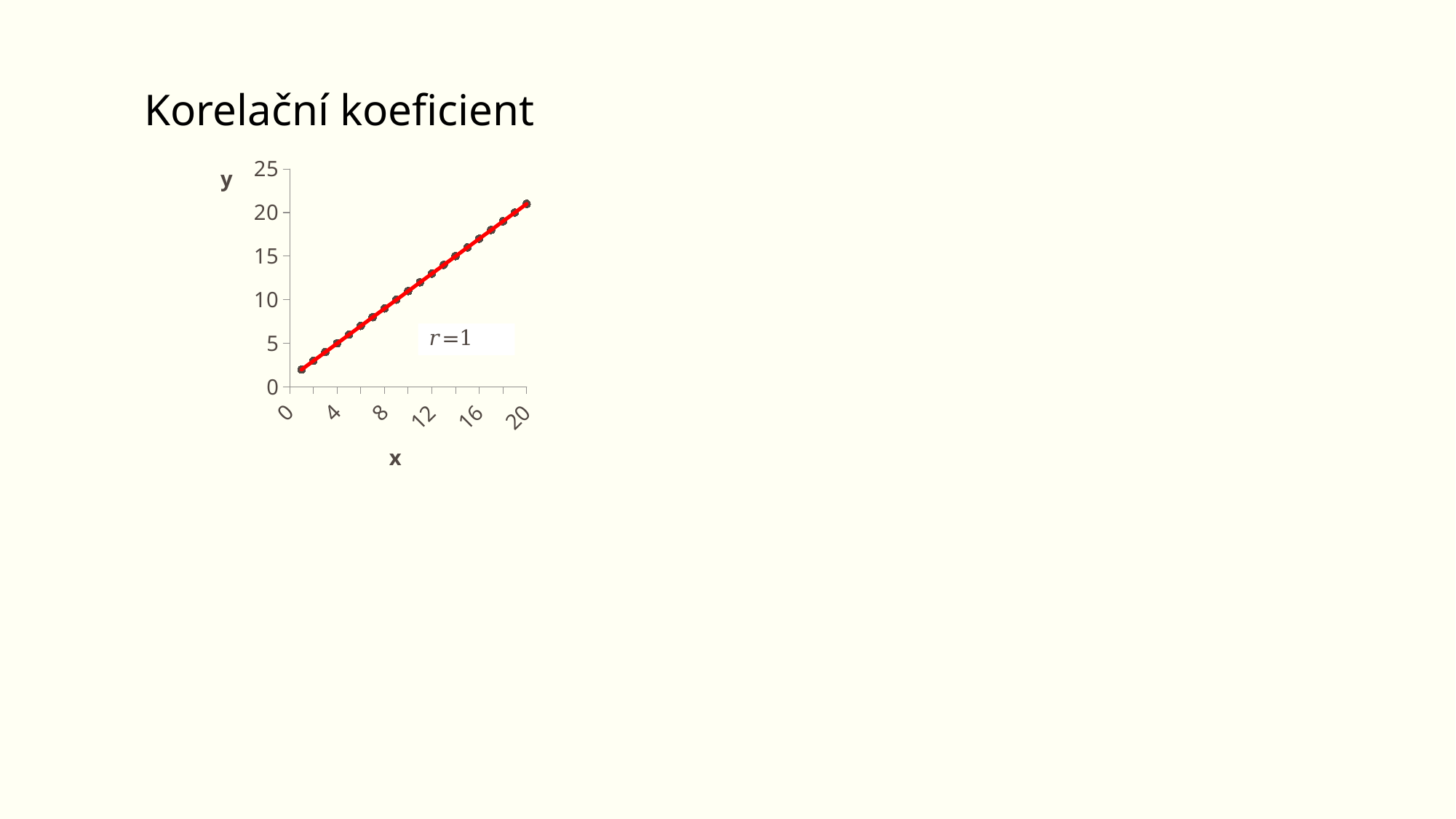
What is the title of the slide containing the chart? Korelační koeficient What value of the correlation coefficient r is printed on the chart? r = 1 Is the y value of the first point (at x = 1) greater or less than 5? less What kind of chart is shown on the slide? scatter chart Is the y value of the point at x = 4 greater or less than 10? less Is the y value of the point at x = 12 greater or less than 10? greater What is the highest tick value shown on the x axis? 20 Which point has the highest y value, the one at x = 4 or the one at x = 16? x = 16 Do the plotted y values rise or fall as x increases? rise